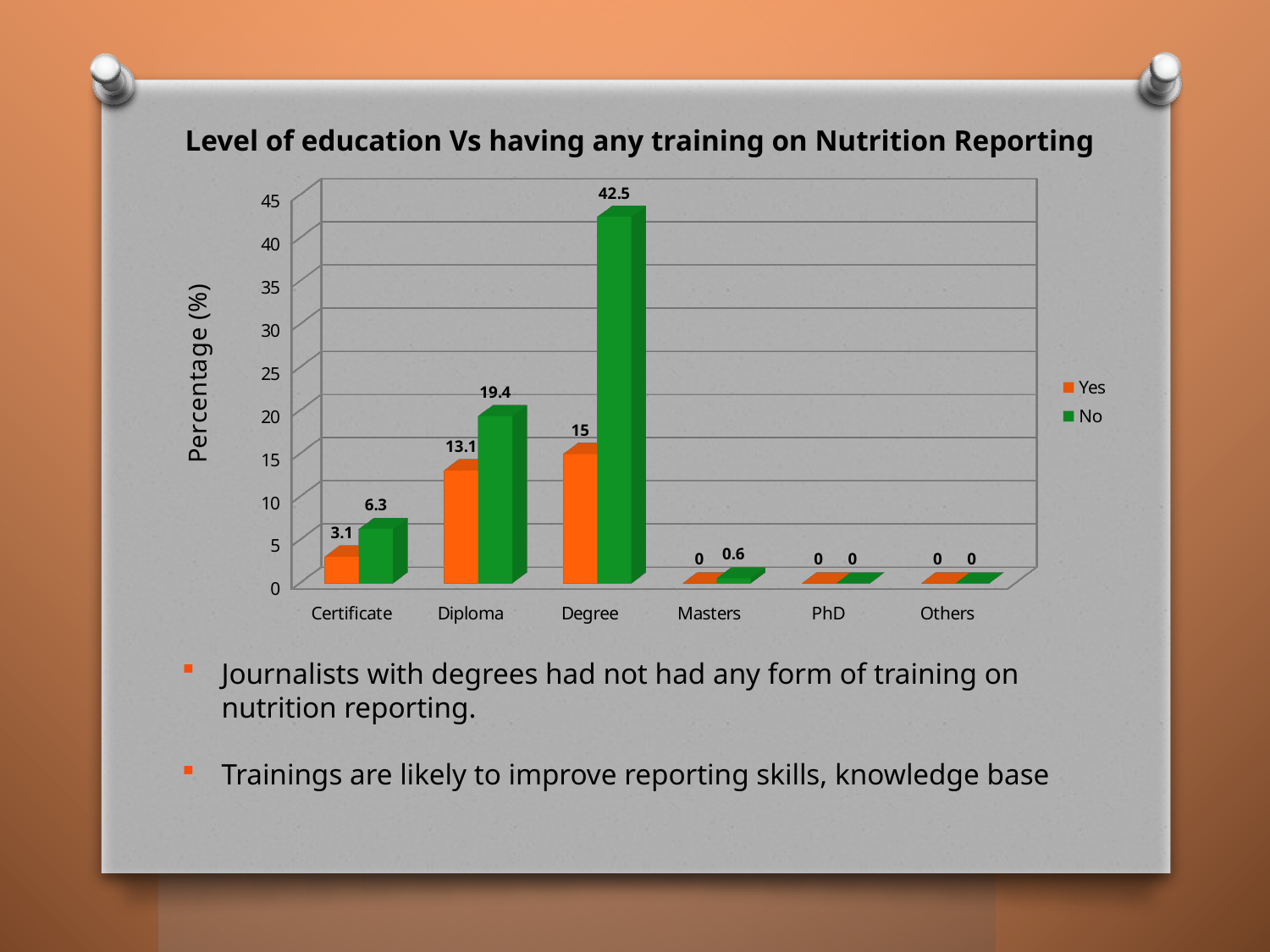
What kind of chart is shown on the slide? Bar chart How many education categories are shown on the x axis? 6 In the Diploma category, which is larger, the "Yes" value or the "No" value? No What is the value for "No" in the Masters category? 0.6 What is the difference between the "No" and "Yes" values in the Certificate category? 3.2 What is the difference between the "No" and "Yes" values in the Degree category? 27.5 How many series does the legend list? 2 Which category has the highest value for the "No" series? Degree What is the value for "Yes" in the Diploma category? 13.1 Which category has the highest value for the "Yes" series? Degree What is the label of the vertical axis? Percentage (%) What is the value for "No" in the Degree category? 42.5